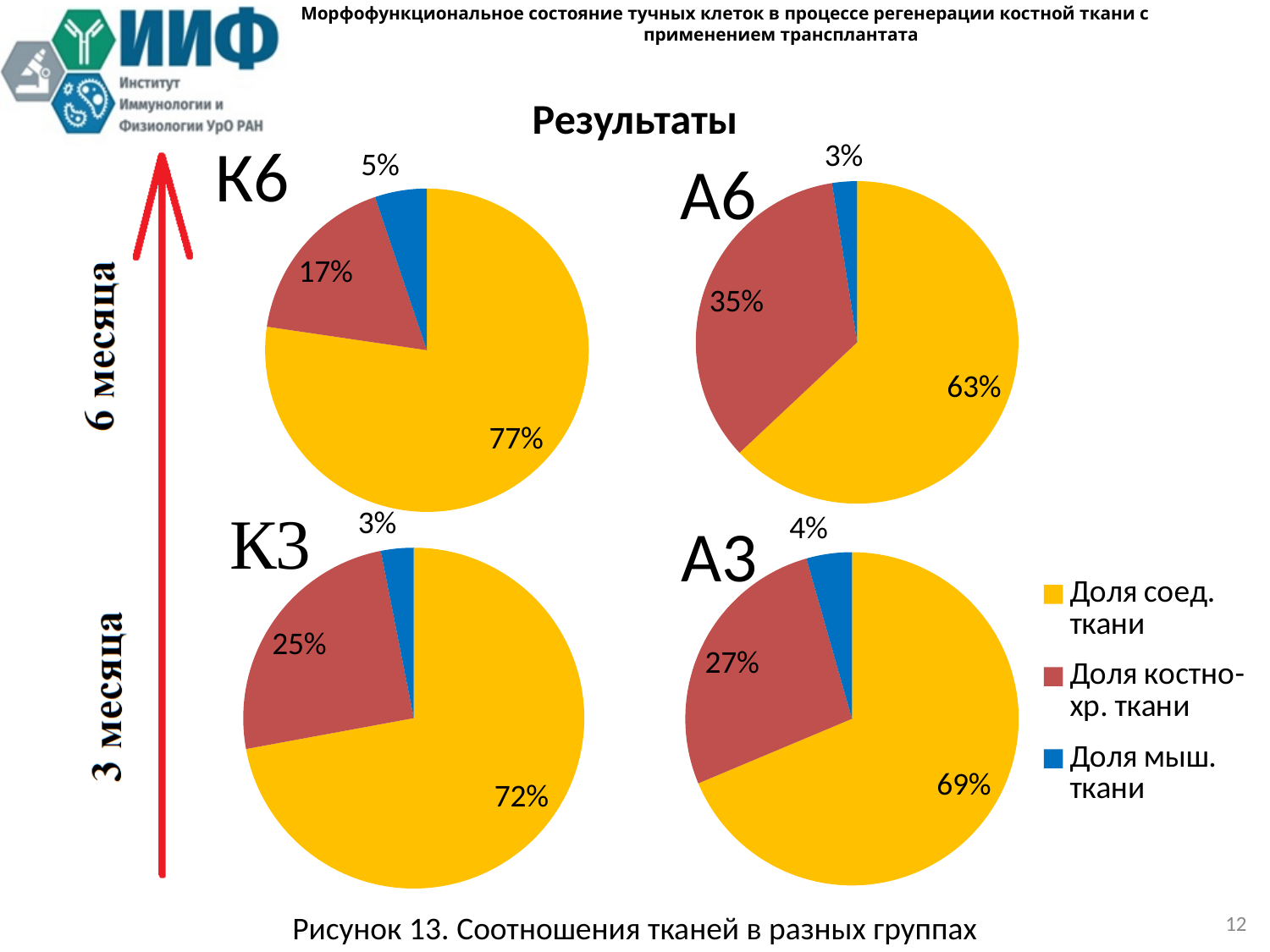
In the А6 pie chart, what share is labelled for Доля костно-хр. ткани (the red slice)? 35% In the А3 pie chart, what share is labelled for Доля соед. ткани (the yellow slice)? 69% In the А6 pie chart, which category has the largest slice? Доля соед. ткани Which is larger: the Доля соед. ткани share in the К3 chart or in the А3 chart? К3 What type of chart is used for the К6, А6, К3 and А3 groups? Pie chart What is the difference between the Доля костно-хр. ткани share in the А6 chart (35%) and in the К6 chart (17%)? 18% In the К6 pie chart, which category has the smallest slice? Доля мыш. ткани In the К3 pie chart, what share is labelled for Доля мыш. ткани (the blue slice)? 3% In the К6 pie chart, what share is labelled for Доля соед. ткани (the yellow slice)? 77% Which colour represents Доля мыш. ткани in the legend? Blue How many entries does the legend on the slide list? 3 How many slices does the А3 pie chart have? 3